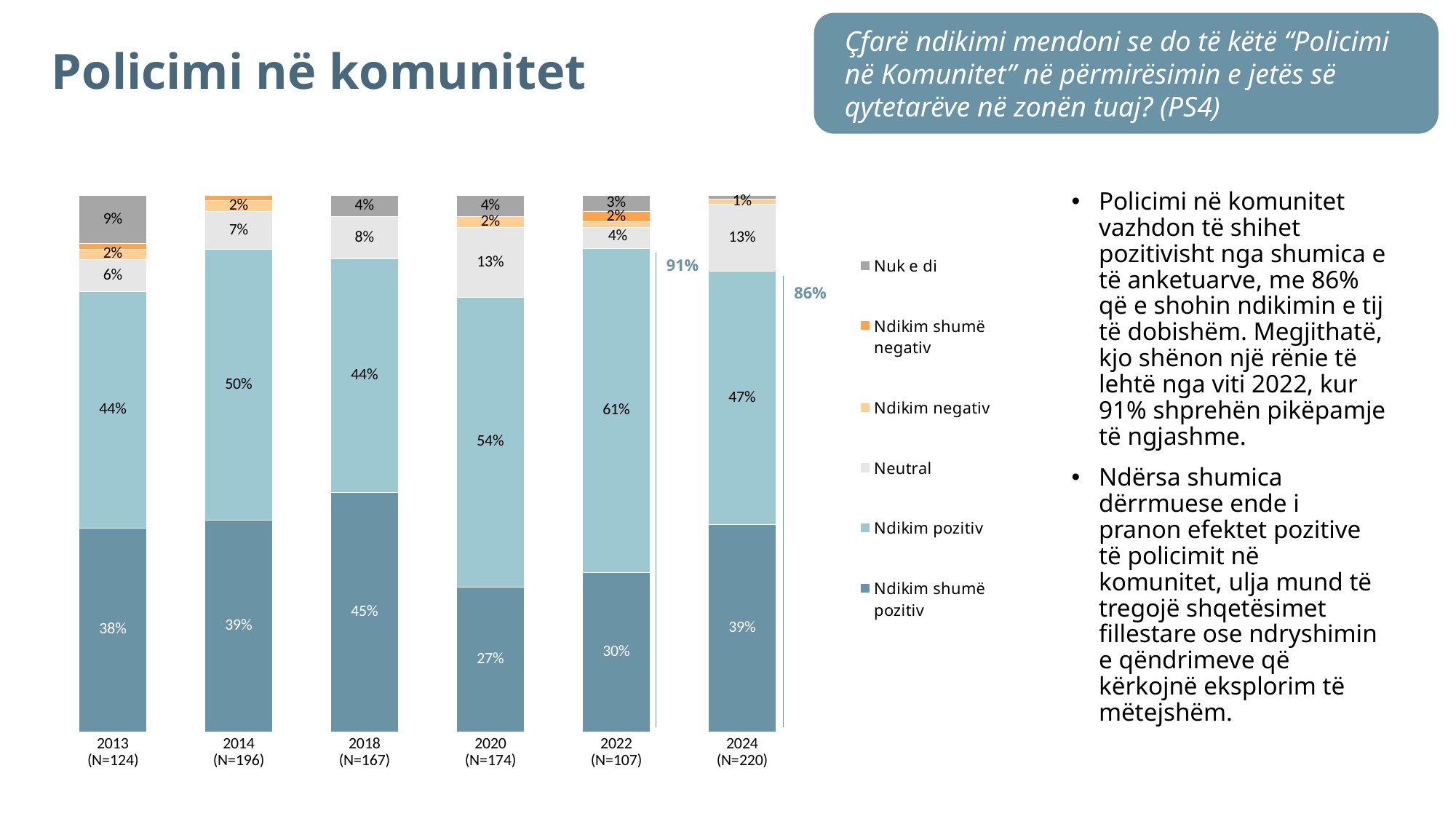
In which year is Ndikim shumë pozitiv lowest? 2020 What kind of chart is shown on the slide? Stacked bar chart What is the difference between the Ndikim pozitiv values for 2022 and 2024? 14 percentage points What is the value for Neutral in 2024? 13% How many series does the legend list? 6 What is the value for Ndikim pozitiv in 2022? 61% Which is larger, Ndikim shumë pozitiv in 2018 or in 2013? 2018 What is the value for Nuk e di in 2013? 9% In which year is Ndikim pozitiv highest? 2022 What is the combined share of Ndikim pozitiv and Ndikim shumë pozitiv in 2024, as labelled on the chart? 86% How many survey years are shown on the x axis? 6 What is the value for Ndikim shumë pozitiv in 2020? 27%